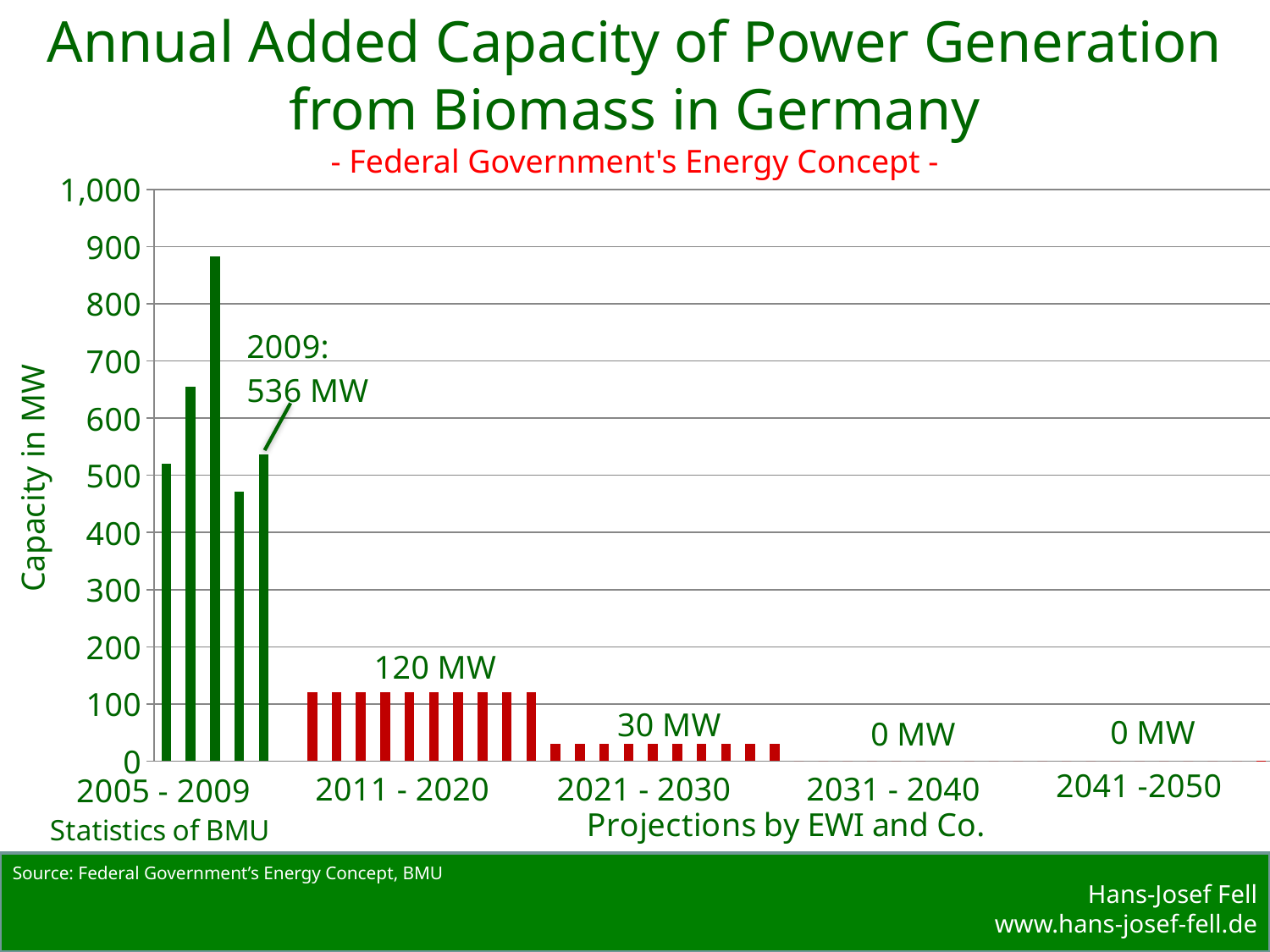
Do the values generally rise or fall moving from left to right along the x axis? fall What is the title of the y axis? Capacity in MW What is the difference between the 2009 value and the projected annual value for 2011 - 2020? 416 MW How many time periods are labelled along the x axis? 5 Is the tallest bar in the 2005 - 2009 group greater or less than 800 MW? greater How much higher is the projected annual added capacity for 2011 - 2020 than for 2021 - 2030? 90 MW Which period has the larger projected annual added capacity, 2011 - 2020 or 2021 - 2030? 2011 - 2020 What annual added capacity is projected for the period 2031 - 2040? 0 MW What annual added capacity is projected for the period 2011 - 2020? 120 MW What kind of chart is shown on the slide? bar chart What annual added capacity is projected for the period 2021 - 2030? 30 MW What was the annual added biomass capacity in Germany in 2009 according to the chart? 536 MW